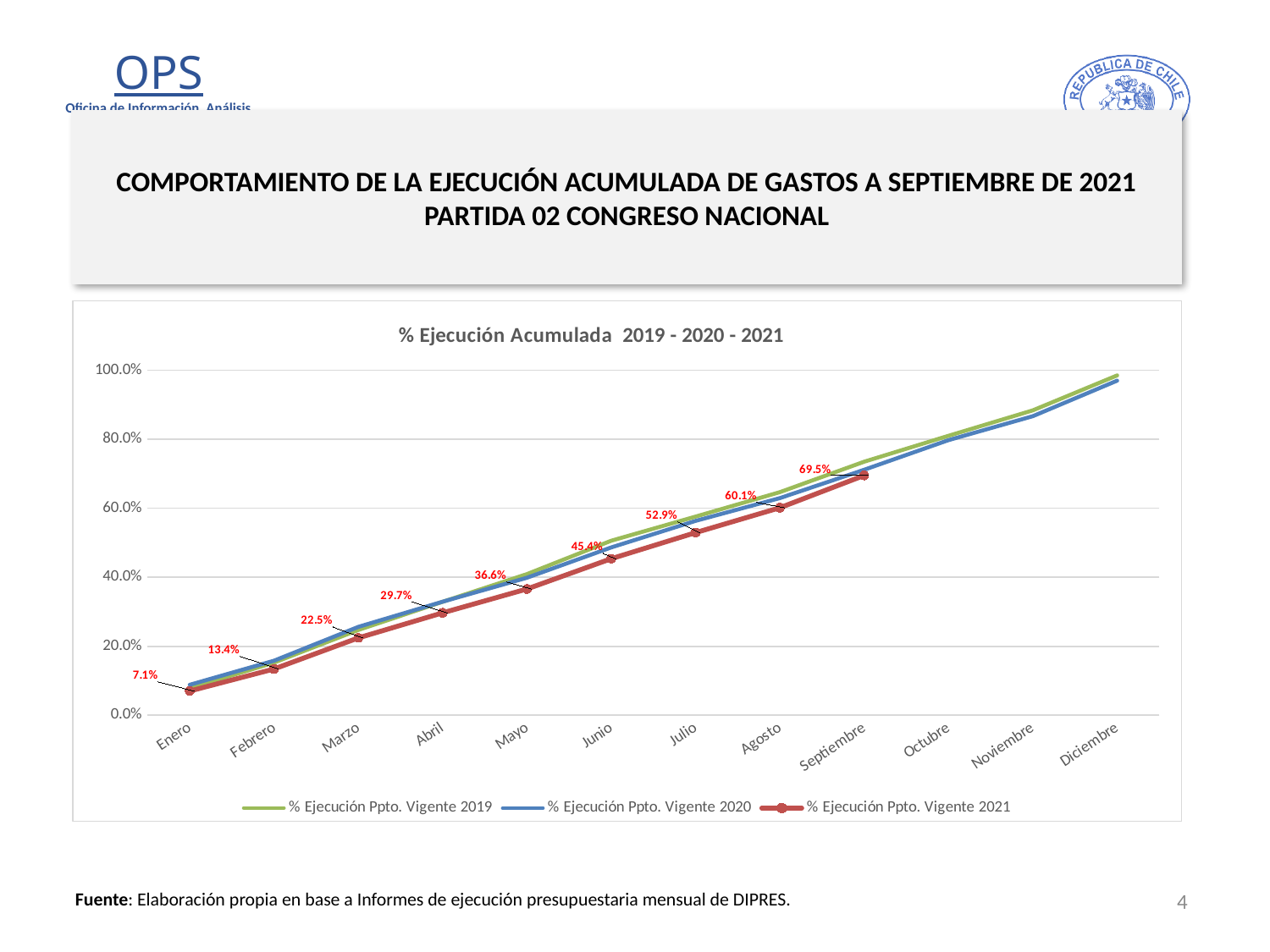
Which month has the highest labelled value for % Ejecución Ppto. Vigente 2021? Septiembre What is the value of % Ejecución Ppto. Vigente 2021 for Septiembre? 69.5% Is the 2021 value for Junio larger or smaller than the 2021 value for Abril? larger How many months are shown on the x axis? 12 What kind of chart is shown on the slide? line chart What is the value of % Ejecución Ppto. Vigente 2021 for Mayo? 36.6% What is the difference in percentage points between the 2021 values for Septiembre and Agosto? 9.4 Is the value for % Ejecución Ppto. Vigente 2019 in Diciembre greater or less than 80.0%? greater What is the value of % Ejecución Ppto. Vigente 2021 for Julio? 52.9% How many series does the legend list? 3 Which month has the lowest labelled value for % Ejecución Ppto. Vigente 2021? Enero What is the value of % Ejecución Ppto. Vigente 2021 for Enero? 7.1%